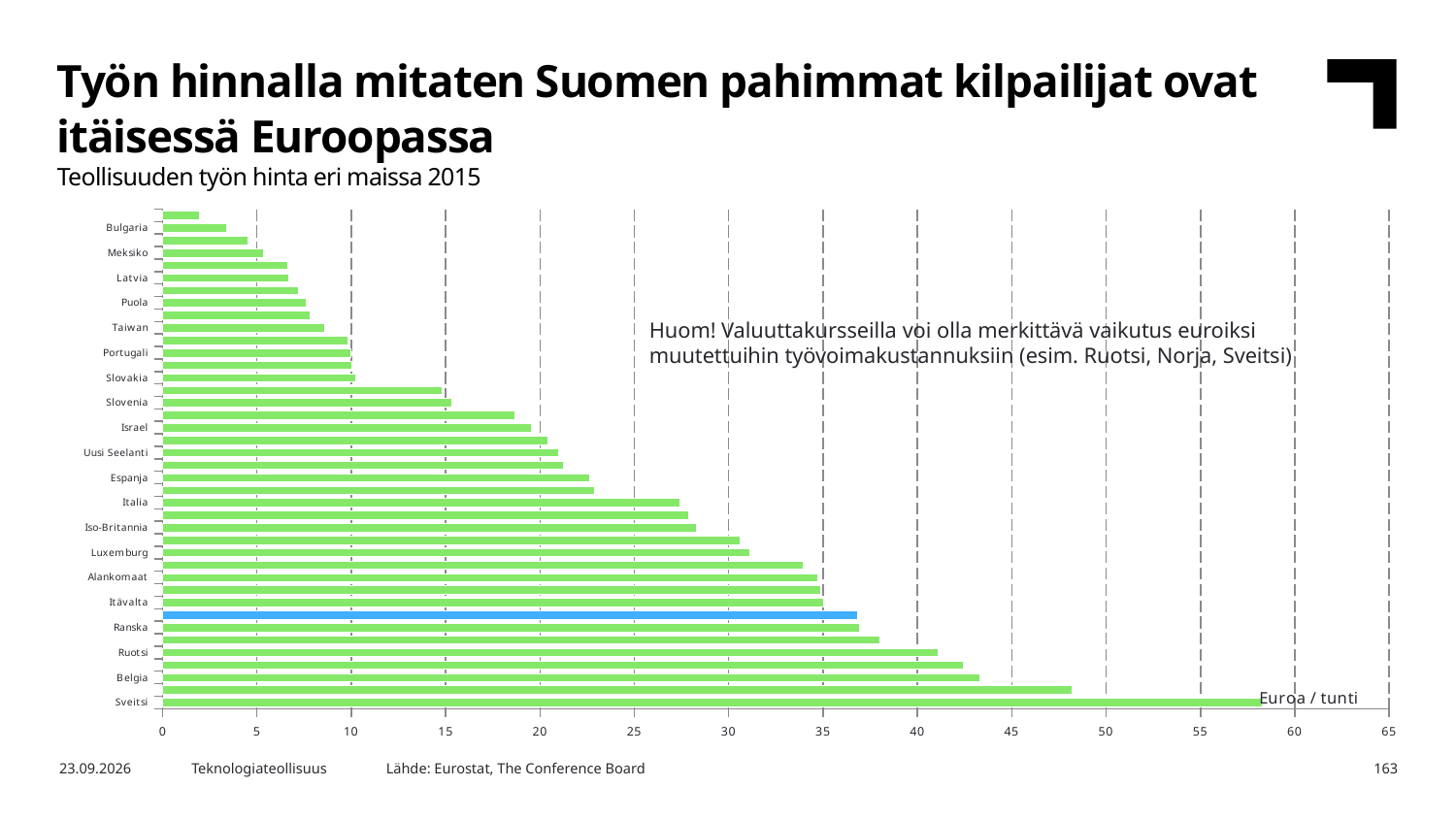
Is the value for Espanja greater or less than 20? greater Is the value for Belgia greater or less than 40? greater Which has the larger value, Belgia or Ruotsi? Belgia Is the value for Slovenia greater or less than 10? greater Do the bar values increase or decrease going from the top of the chart to the bottom? increase Which has the larger value, Luxemburg or Portugali? Luxemburg Which labelled country has the highest labour cost in the chart? Sveitsi What kind of chart is shown on the slide? bar chart What unit is shown next to the longest bar in the chart? Euroa / tunti